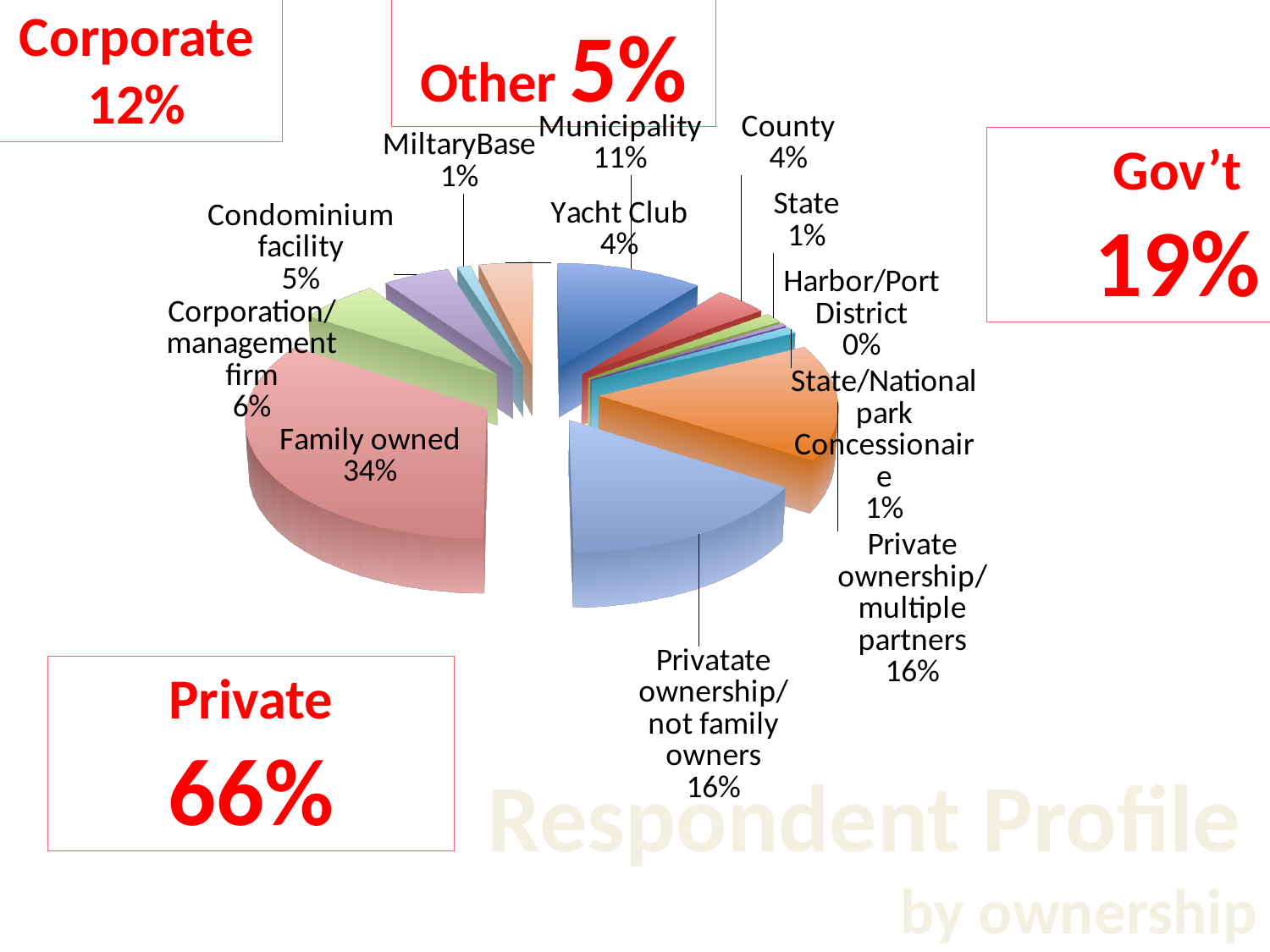
Which category has the smallest slice of the pie? Harbor/Port District According to the red summary boxes, what percentage of respondents is Private? 66% How many categories are labelled on the pie chart? 12 Which is larger, the Condominium facility share or the Corporation/management firm share? Corporation/management firm What share of respondents is Corporation/management firm? 6% Which category has the largest slice of the pie? Family owned What share of respondents is Family owned? 34% What kind of chart is shown on the slide? pie chart What share of respondents is Private ownership/multiple partners? 16% What share of respondents is Municipality? 11% What share of respondents is Harbor/Port District? 0% What is the difference between the Family owned share and the Municipality share? 23 percentage points